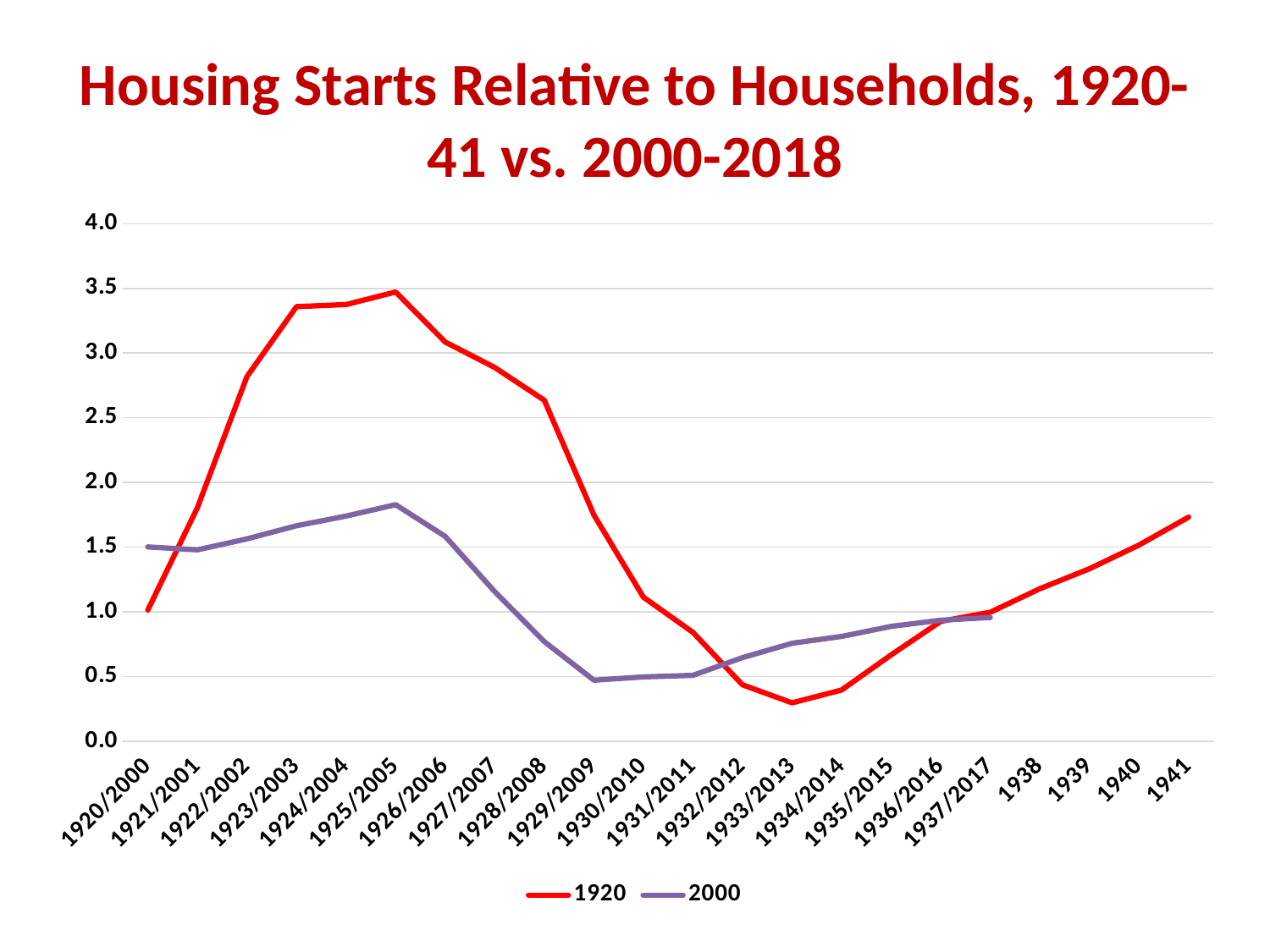
Is the value of the 1920 series at 1925/2005 greater or less than 3.0? greater Which colour is used for the 2000 series? purple Does the 1920 series rise or fall from 1937/2017 to 1941? rise How many series does the legend list? 2 What kind of chart is shown on the slide? line chart At 1933/2013, which series has the larger value, 1920 or 2000? 2000 How many categories are shown on the x axis? 22 At which x-axis category does the 1920 series reach its highest value? 1925/2005 At which x-axis category does the 1920 series reach its lowest value? 1933/2013 At which x-axis category does the 2000 series reach its highest value? 1925/2005 Is the value of the 1920 series at 1933/2013 greater or less than 0.5? less Is the value of the 2000 series at 1925/2005 greater or less than 2.0? less